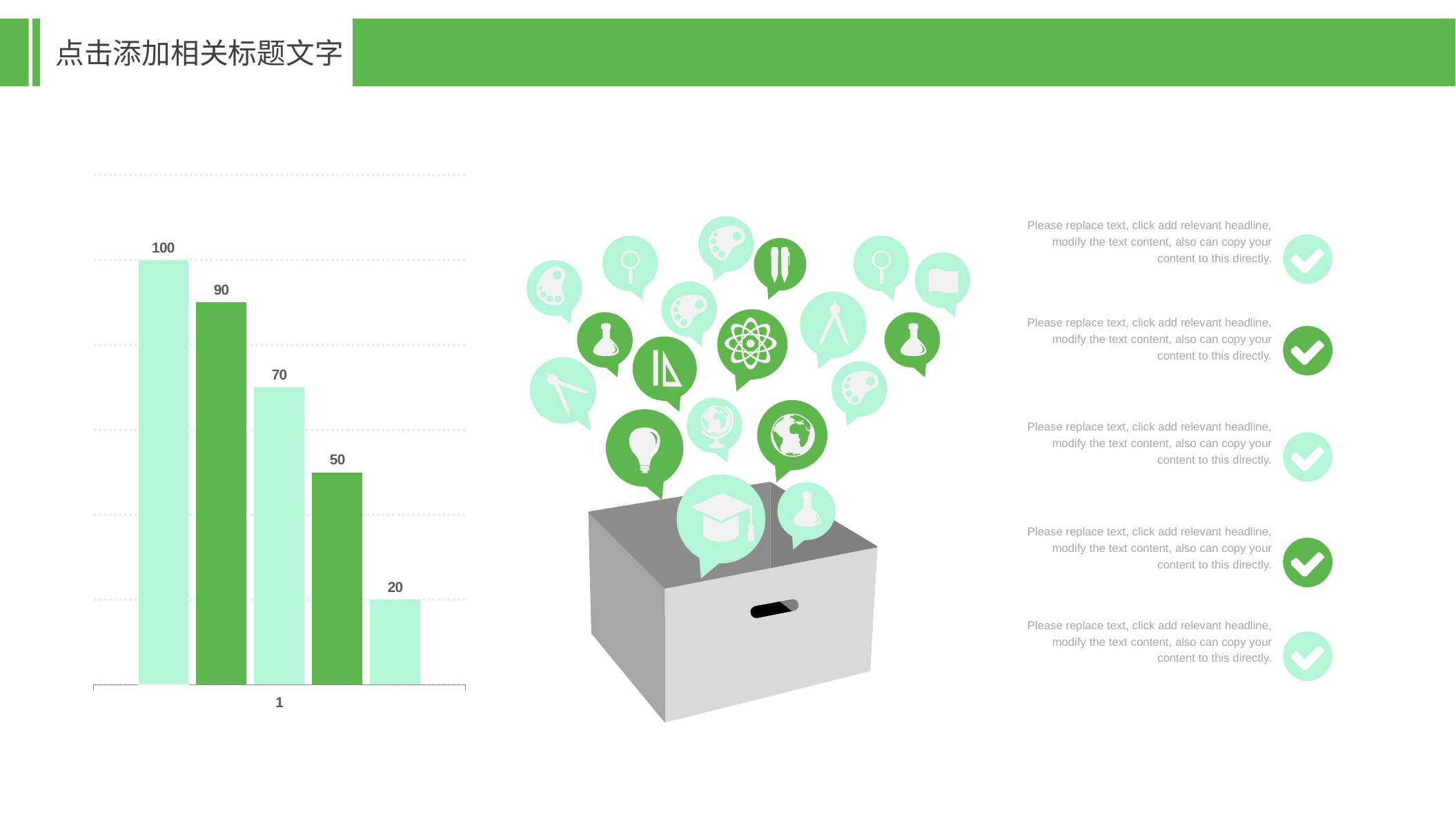
What category label is shown on the x axis of the chart? 1 What is the value shown on the shortest bar in the chart? 20 What kind of chart is shown on the left of the slide? bar chart How many bars are plotted in the chart? 5 What is the data label on the second bar from the left? 90 Do the bar values rise or fall from left to right across the chart? fall Which is larger, the fourth bar or the fifth bar? the fourth bar What is the difference between the first bar (100) and the last bar (20)? 80 What is the data label on the fourth bar from the left? 50 What is the value shown on the tallest bar in the chart? 100 What is the data label on the third bar from the left? 70 What is the difference between the second bar (90) and the third bar (70)? 20